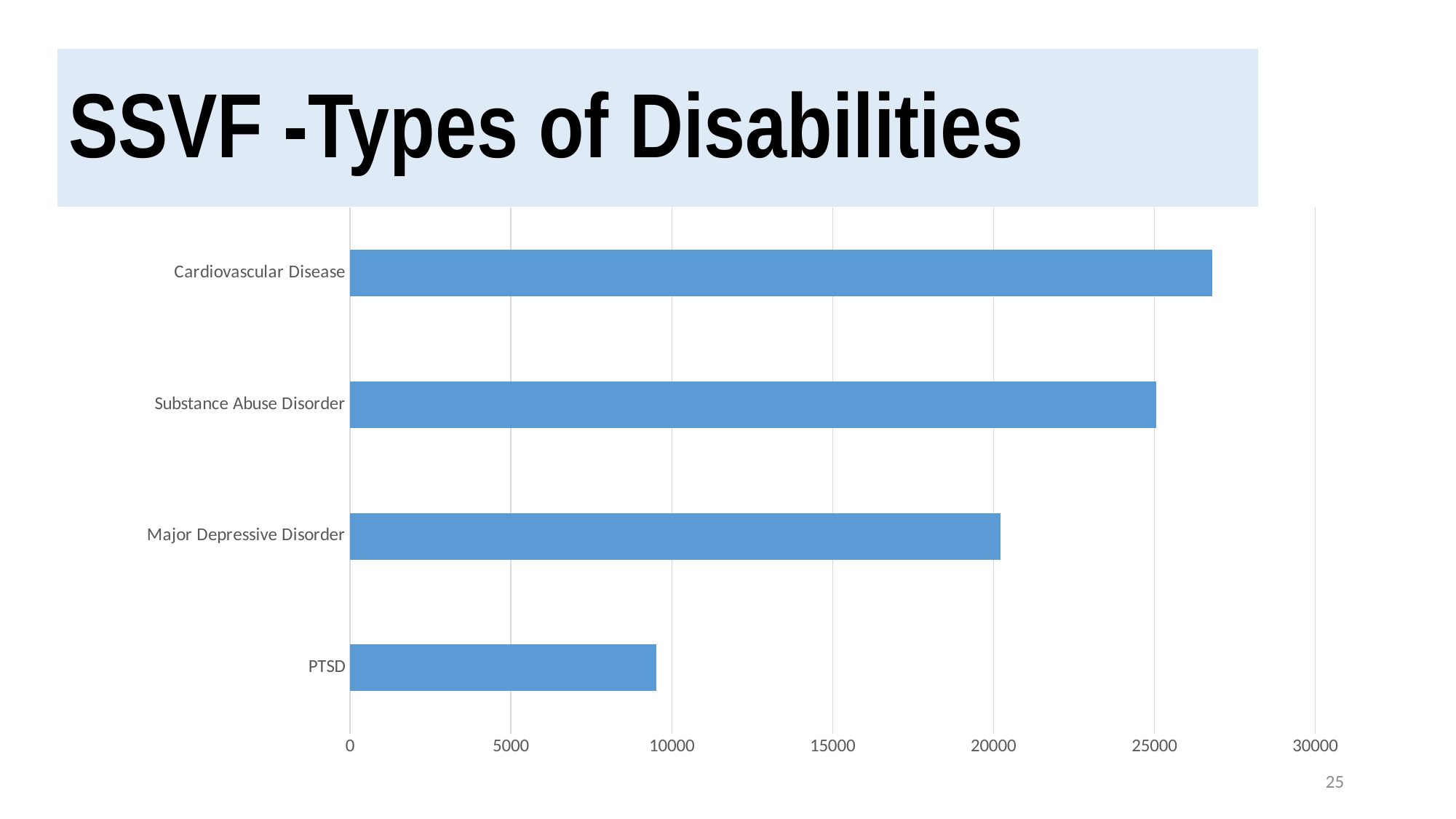
Is the value for Cardiovascular Disease greater or less than 25000? greater Is the value for Major Depressive Disorder greater or less than 15000? greater What is the title of the slide containing the chart? SSVF -Types of Disabilities Which disability category has the highest value? Cardiovascular Disease How many disability categories are plotted in the chart? 4 What is the highest tick value shown on the horizontal axis? 30000 Is the value for Substance Abuse Disorder greater or less than 20000? greater Which is larger, the value for Cardiovascular Disease or the value for Substance Abuse Disorder? Cardiovascular Disease What kind of chart is shown on the slide? Bar chart Which disability category has the lowest value? PTSD Which is larger, the value for Major Depressive Disorder or the value for PTSD? Major Depressive Disorder